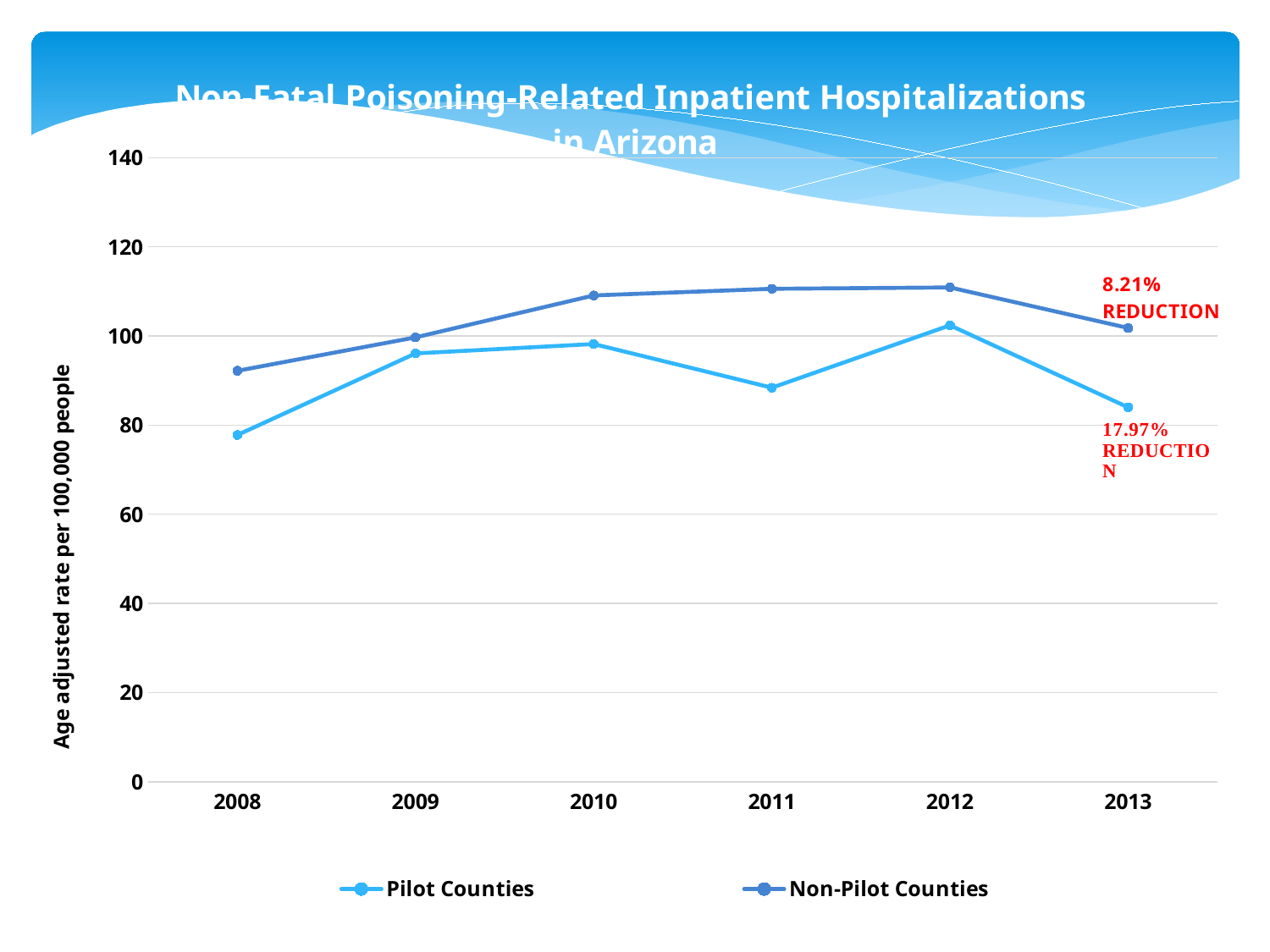
What kind of chart is shown on the slide? line chart How many series does the legend list? 2 Does the Non-Pilot Counties line rise or fall from 2008 to 2012? rise In which year is the Pilot Counties rate highest? 2012 Is the Non-Pilot Counties value for 2010 greater or less than 100? greater How many years are plotted along the x axis? 6 Is the Pilot Counties value for 2008 greater or less than 80? less In which year is the Pilot Counties rate lowest? 2008 What percentage reduction is annotated for the Pilot Counties line? 17.97% Is the Non-Pilot Counties value for 2008 greater or less than 100? less In which year is the Non-Pilot Counties rate lowest? 2008 In 2011, which series has the higher rate, Pilot Counties or Non-Pilot Counties? Non-Pilot Counties